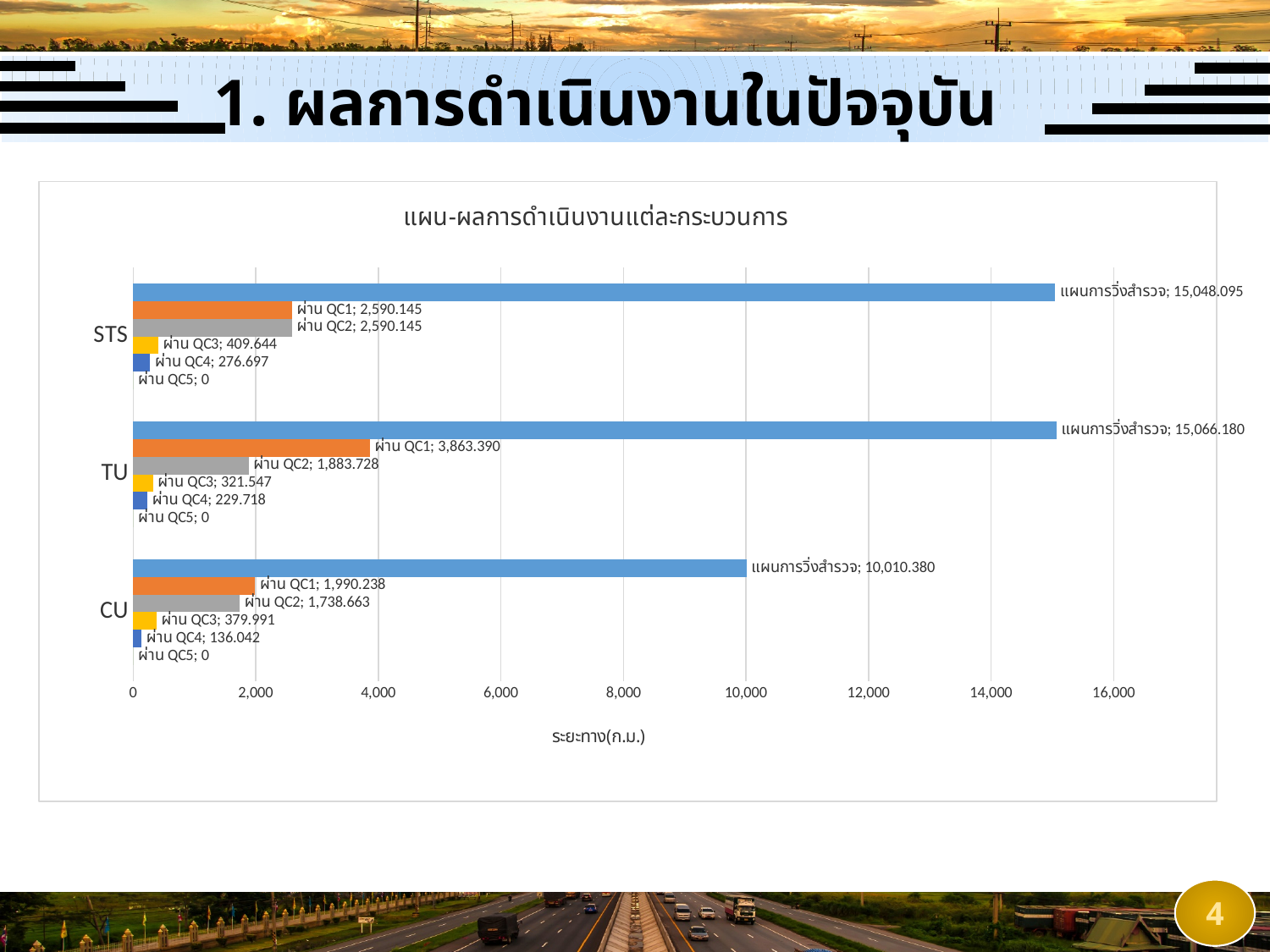
Is the แผนการวิ่งสำรวจ value for CU greater or less than 8,000? greater What is the value of ผ่าน QC3 for STS? 409.644 Which category has the highest ผ่าน QC1 value? TU Which is larger, the ผ่าน QC2 value for STS or for CU? STS What is the difference between the ผ่าน QC1 values for TU and STS? 1,273.245 What is the value of แผนการวิ่งสำรวจ for STS? 15,048.095 What type of chart is shown on the slide? Bar chart What is the value of ผ่าน QC1 for TU? 3,863.390 How many categories are shown on the vertical axis of the chart? 3 Which category has the lowest แผนการวิ่งสำรวจ value? CU What is the value of ผ่าน QC4 for CU? 136.042 What is the title of the horizontal axis of the chart? ระยะทาง(ก.ม.)